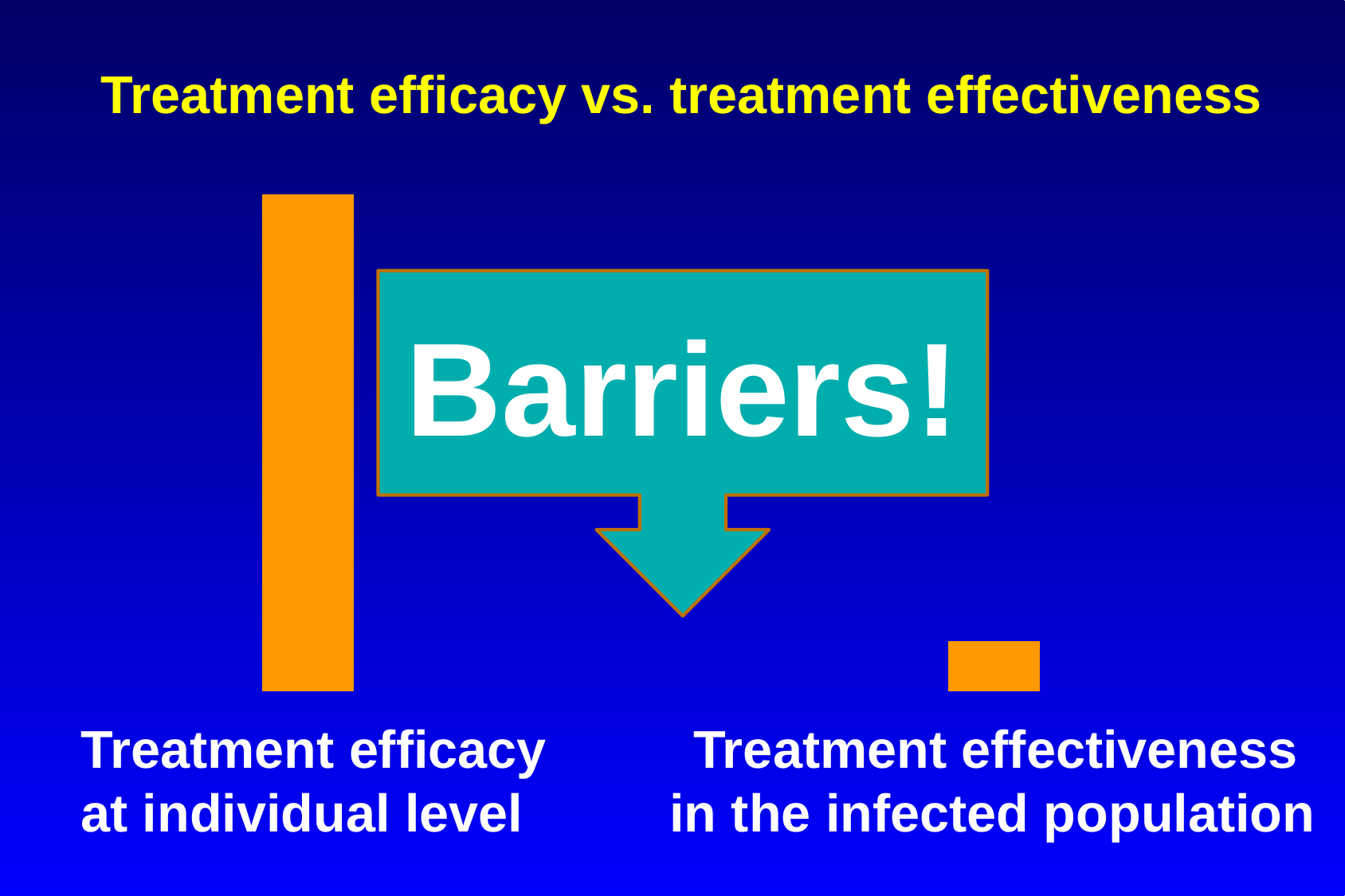
Which bar is taller: 'Treatment efficacy at individual level' or 'Treatment effectiveness in the infected population'? Treatment efficacy at individual level How many bars are shown in the chart? 2 What word is written in the box with the downward arrow between the two bars? Barriers! What is the title of the slide? Treatment efficacy vs. treatment effectiveness Which category has the highest bar? Treatment efficacy at individual level What kind of chart is shown on the slide? bar chart Which category has the lowest bar? Treatment effectiveness in the infected population